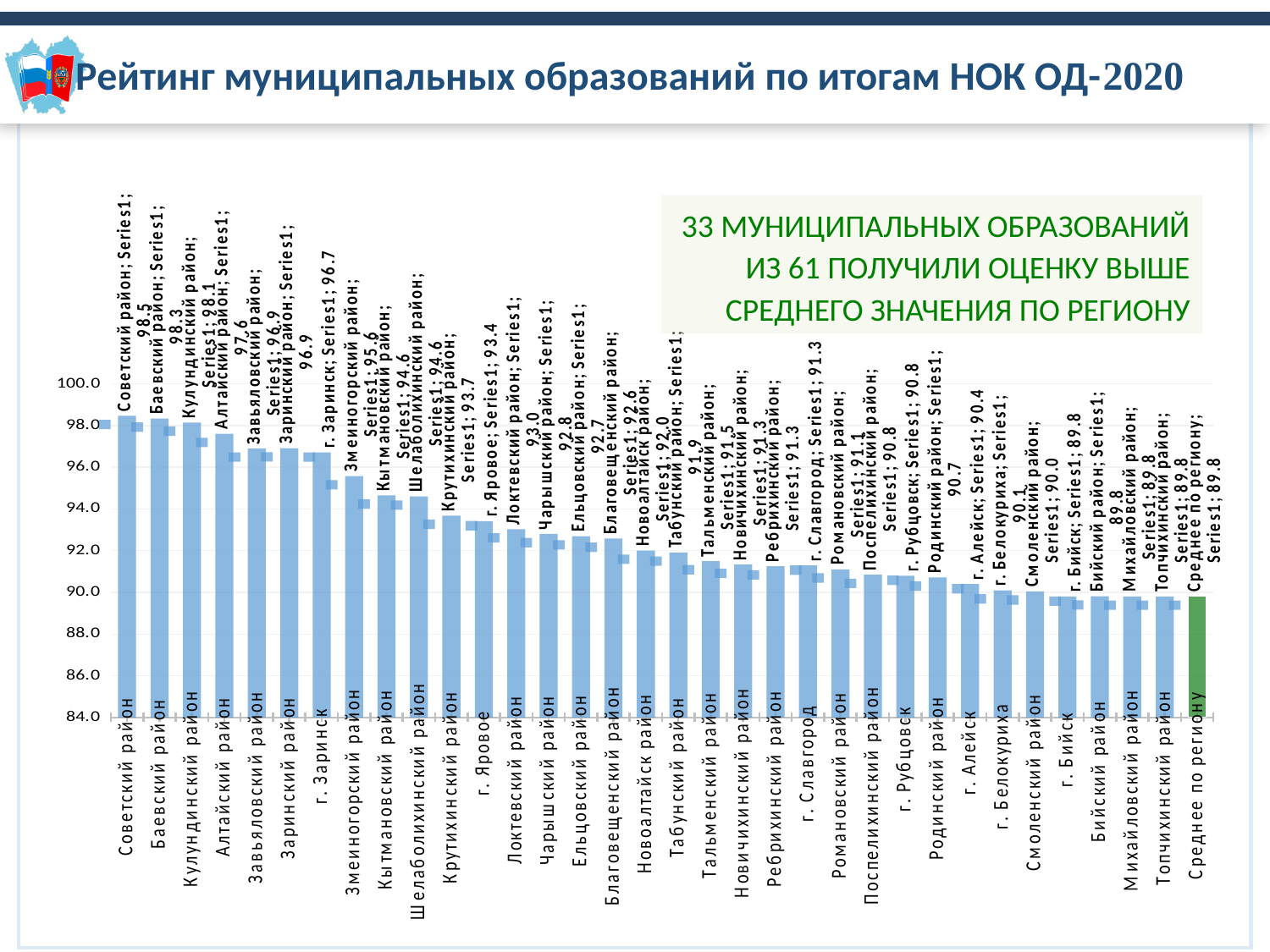
What value is shown for Среднее по региону? 89.8 Do the values rise or fall from left to right along the x axis? fall Which has a larger value, Змеиногорский район or Крутихинский район? Змеиногорский район Which bar is coloured green instead of blue? Среднее по региону How many bars are plotted in the chart? 34 Which category has the highest value? Советский район What value is shown for г. Яровое? 93.4 What kind of chart is shown on the slide? bar chart What value is shown for Родинский район? 90.7 What value is shown for Советский район? 98.5 What is the difference between the values for Советский район and Среднее по региону? 8.7 Is the value for Алтайский район greater or less than 96.0? greater